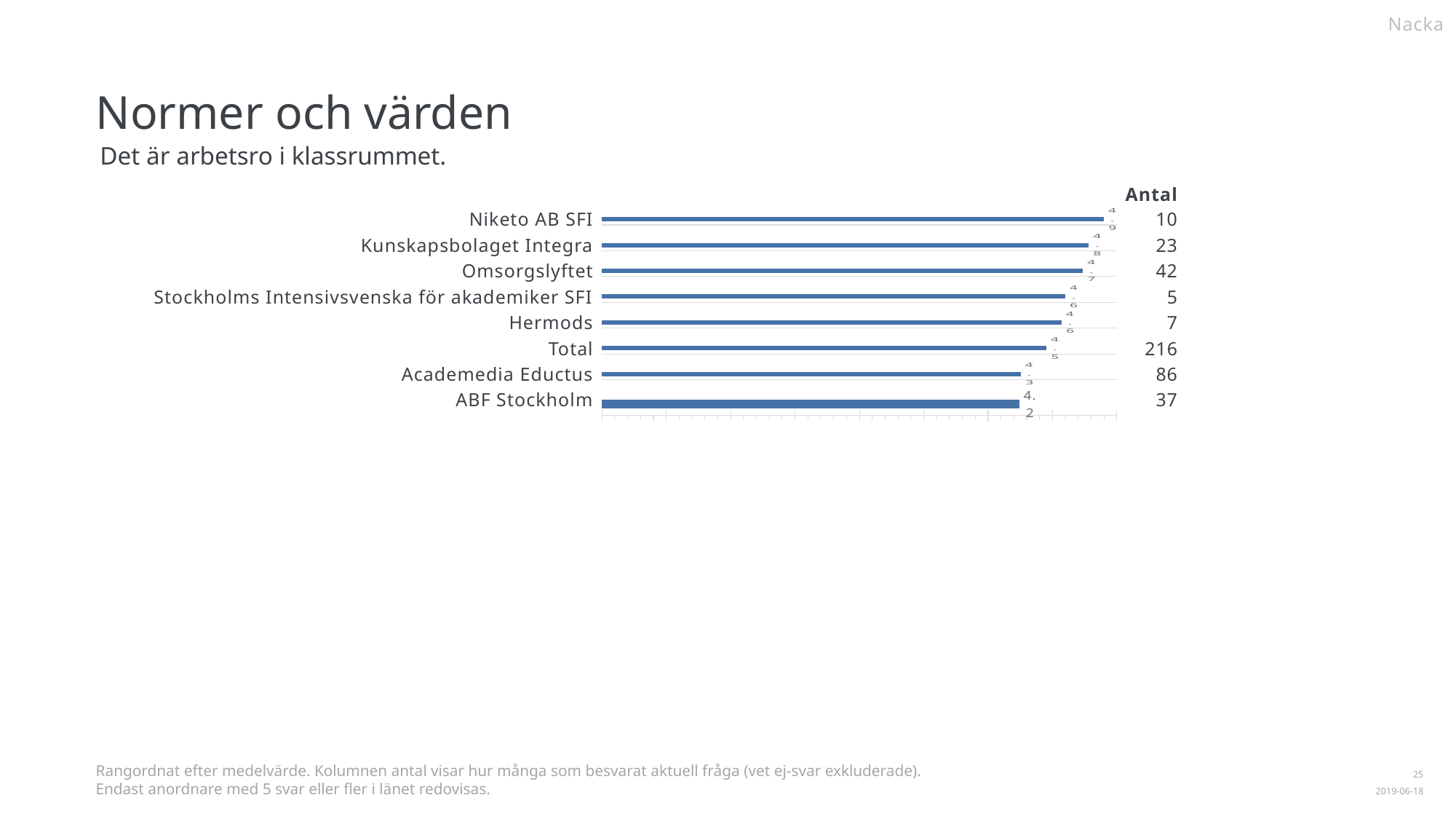
What is the value shown for Niketo AB SFI? 4.9 What is the difference between the values for Niketo AB SFI and ABF Stockholm? 0.7 What is the Antal (number of respondents) shown for Total? 216 How many categories (bars) does the chart show? 8 Which category has the lowest value in the chart? ABF Stockholm What is the value shown for Academedia Eductus? 4.3 What is the value shown for ABF Stockholm? 4.2 What is the subtitle (statement) shown above the chart? Det är arbetsro i klassrummet. What kind of chart is shown on the slide? bar chart What is the value shown for Total? 4.5 Which category has the highest value in the chart? Niketo AB SFI Which has a larger value, Kunskapsbolaget Integra or ABF Stockholm? Kunskapsbolaget Integra